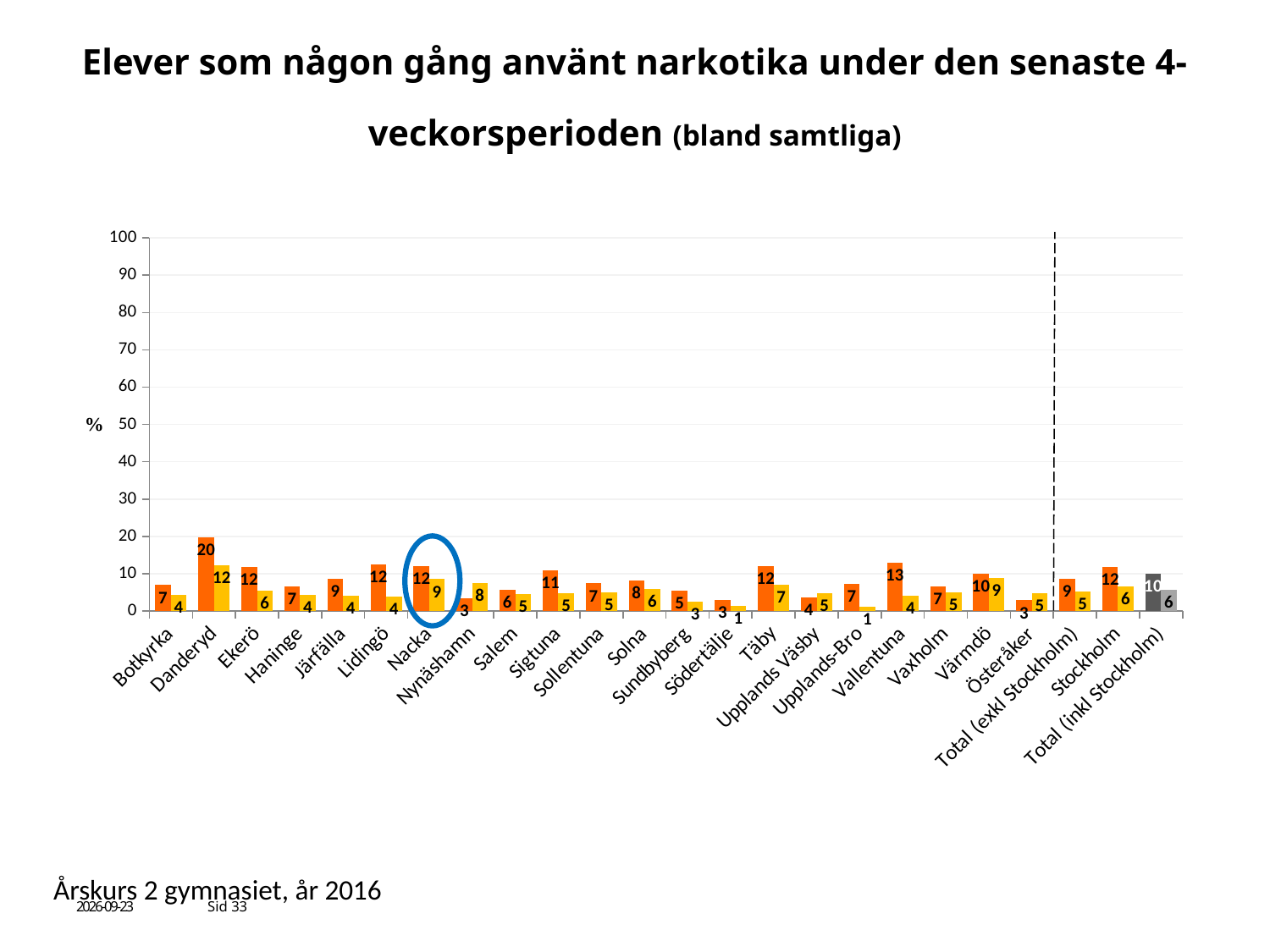
Which municipality has the highest orange (first) bar? Danderyd What is the value of the orange (first) bar for Vallentuna? 13 Which category has the highest yellow (second) bar? Danderyd What is the value of the yellow (second) bar for Nacka? 9 What is the value of the yellow (second) bar for Total (inkl Stockholm)? 6 What is the difference between the orange and yellow bars for Danderyd? 8 Is the value of the orange bar for Danderyd greater or less than 10? greater Which municipality's bars are circled in blue on the chart? Nacka How many categories are shown on the x axis? 24 What is the value of the orange (first) bar for Danderyd? 20 Which is larger for Nynäshamn, the orange (first) bar or the yellow (second) bar? the yellow (second) bar What kind of chart is shown on the slide? bar chart